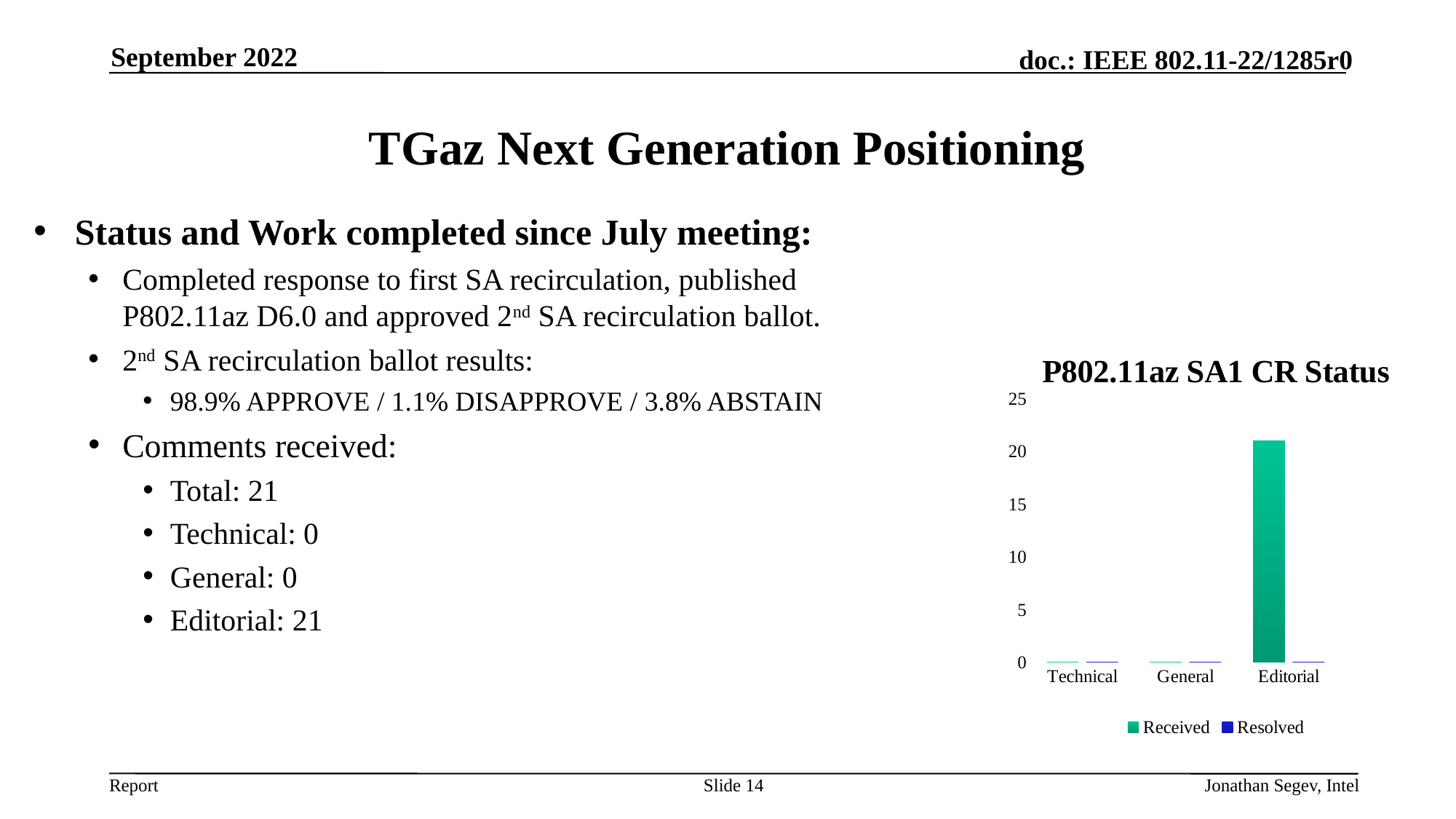
Is the Received value for Editorial in the P802.11az SA1 CR Status chart greater or less than 25? less How many series does the legend of the P802.11az SA1 CR Status chart list? 2 What is the title of the chart on the slide? P802.11az SA1 CR Status Which category has the highest Received value in the P802.11az SA1 CR Status chart? Editorial What kind of chart is the P802.11az SA1 CR Status chart? bar chart In the P802.11az SA1 CR Status chart, which is larger: the Received value for Editorial or the Received value for Technical? Editorial What is the highest value shown on the y axis of the P802.11az SA1 CR Status chart? 25 What is the Received value for General in the P802.11az SA1 CR Status chart? 0 What are the two series named in the legend of the P802.11az SA1 CR Status chart? Received and Resolved Is the Received value for Editorial in the P802.11az SA1 CR Status chart greater or less than 20? greater What is the Received value for Technical in the P802.11az SA1 CR Status chart? 0 How many categories are shown on the x axis of the P802.11az SA1 CR Status chart? 3